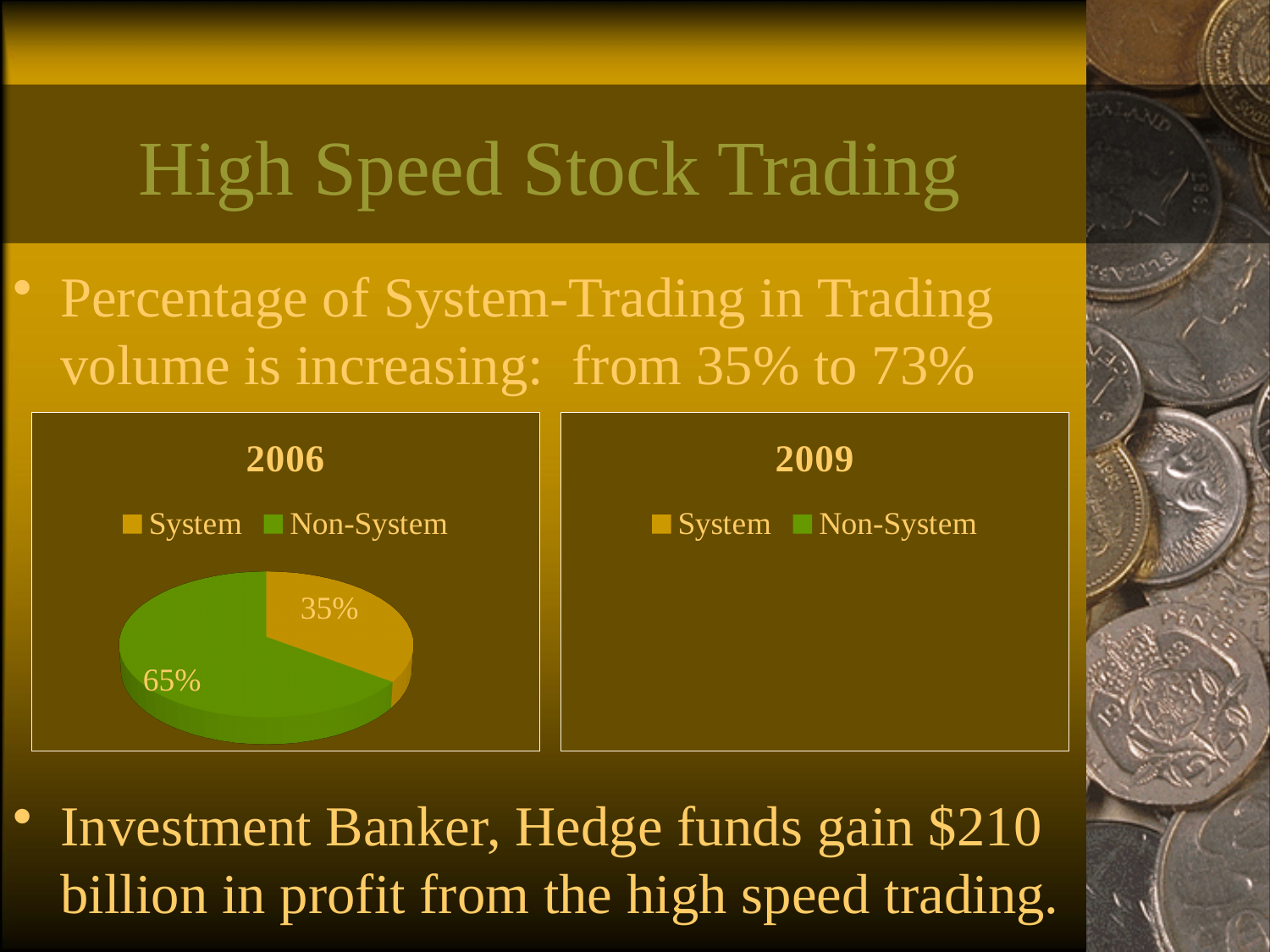
In the 2006 chart, what is the difference in percentage points between Non-System and System? 30 In the 2006 chart, which is larger, System or Non-System? Non-System What kind of chart is the 2006 chart? Pie chart How many slices does the 2006 pie chart have? 2 In the 2006 chart, what percentage is shown for Non-System? 65% In the 2006 chart, which slice is the smallest? System In the 2006 chart, what percentage is shown for System? 35% In the 2006 chart, what share of the pie does the System slice represent? 35% What is the title of the chart on the right side of the slide? 2009 How many entries does the legend of the 2006 chart list? 2 In the 2006 chart, what colour is the Non-System slice? Green In the 2006 chart, which slice is the largest? Non-System